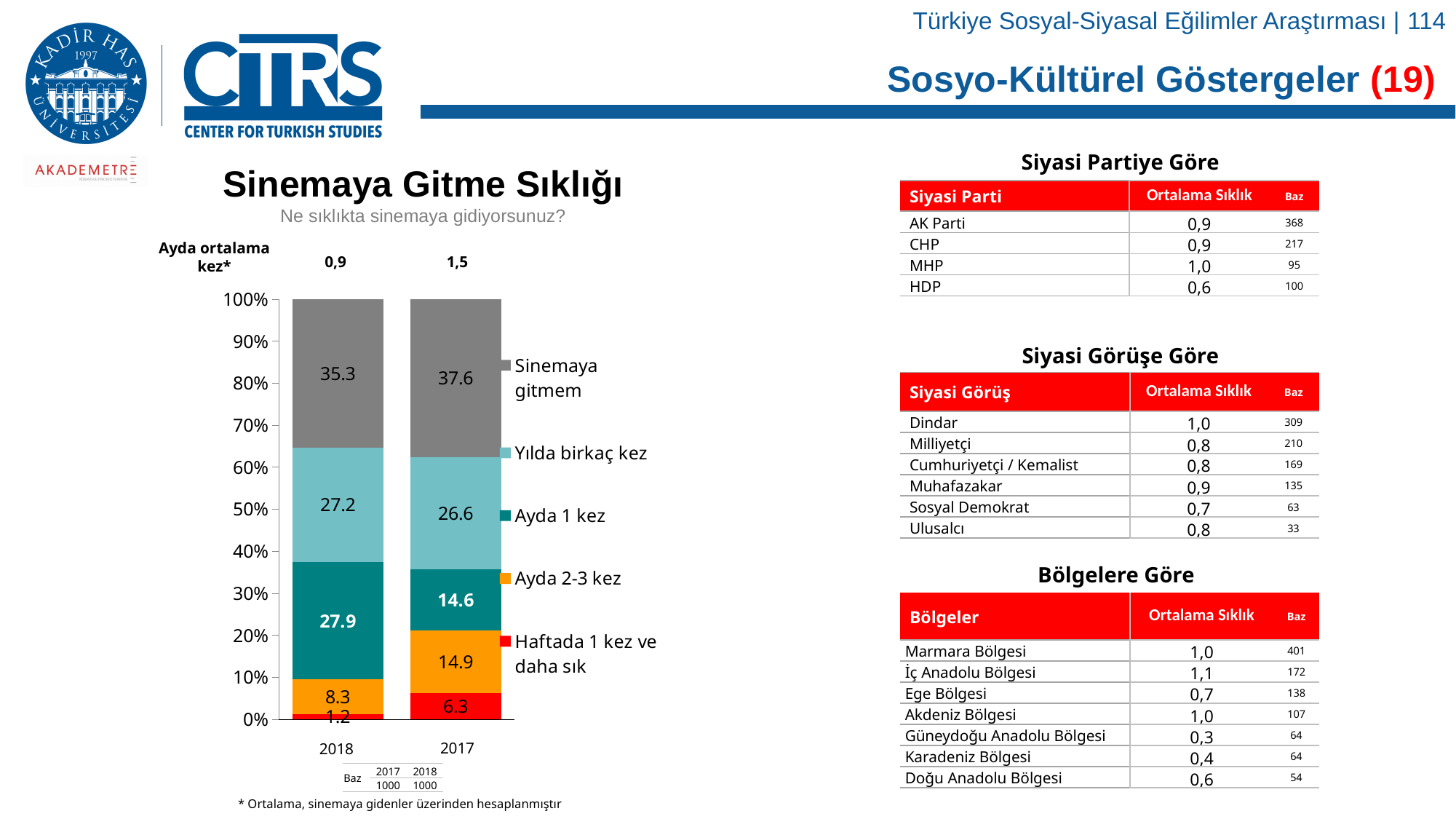
Which segment is the smallest in the 2018 bar? Haftada 1 kez ve daha sık What is the value for 'Ayda 1 kez' in the 2017 bar? 14.6 What is the value for 'Sinemaya gitmem' in the 2018 bar? 35.3 What is the difference between the 'Ayda 1 kez' values for 2018 and 2017? 13.3 Which year has the larger value for 'Haftada 1 kez ve daha sık', 2018 or 2017? 2017 Which segment is the largest in the 2017 bar? Sinemaya gitmem How many bars (years) are plotted in the chart? 2 How many series does the chart legend list? 5 What is the value for 'Haftada 1 kez ve daha sık' in the 2018 bar? 1.2 What is the title of the chart? Sinemaya Gitme Sıklığı What is the value for 'Ayda 2-3 kez' in the 2017 bar? 14.9 What kind of chart is shown on the slide? stacked bar chart